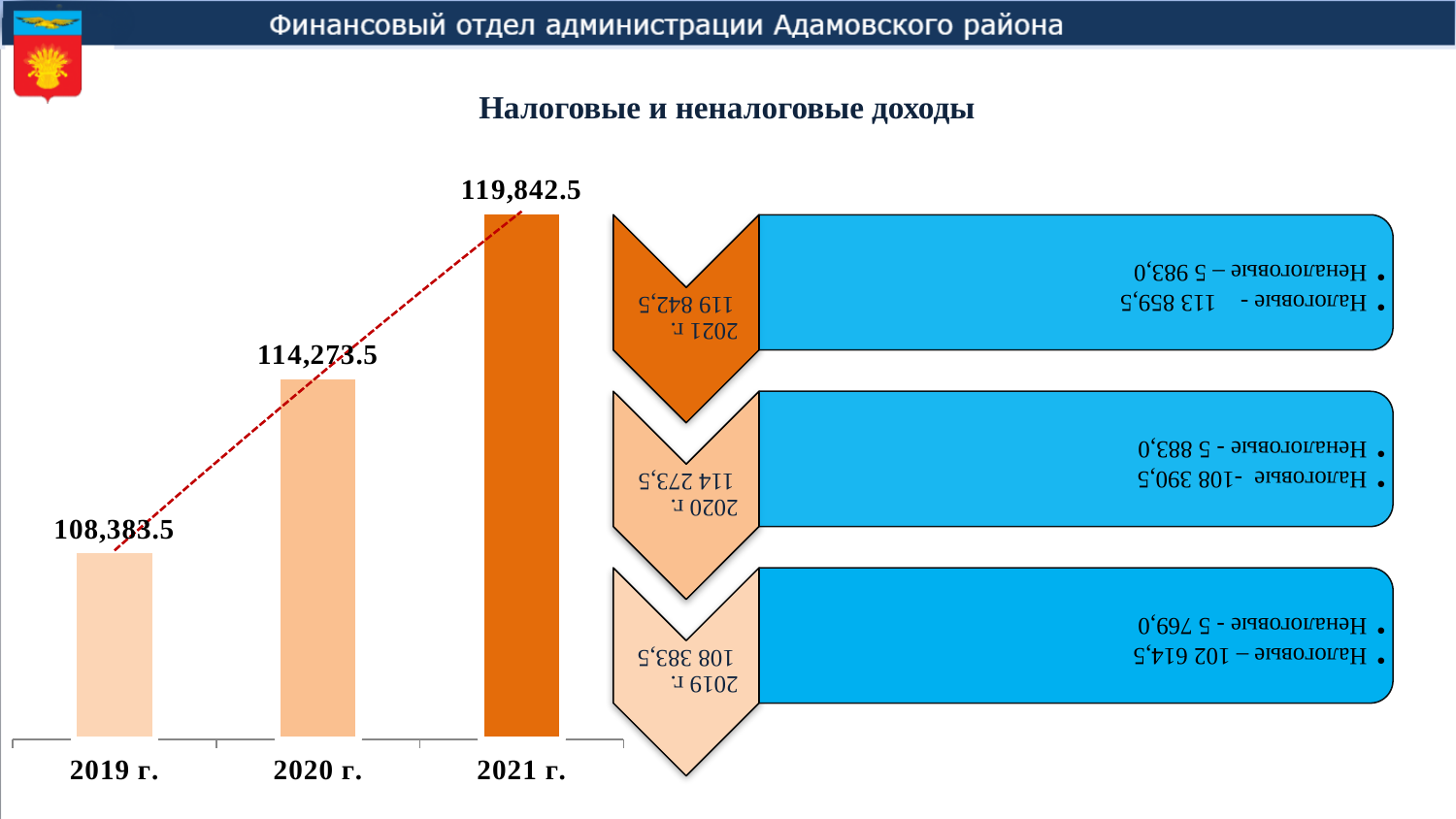
What is the value shown for 2019 г.? 108,383.5 How many years (bars) are shown in the chart? 3 What is the difference between the values for 2021 г. and 2019 г.? 11,459 What is the value shown for 2021 г.? 119,842.5 What is the difference between the values for 2021 г. and 2020 г.? 5,569 Which year has the highest value in the bar chart? 2021 г. What is the difference between the values for 2020 г. and 2019 г.? 5,890 Do the values rise or fall from 2019 г. to 2021 г.? rise Which is larger, the value for 2020 г. or the value for 2019 г.? 2020 г. Which year has the lowest value in the bar chart? 2019 г. What kind of chart is shown on the slide? bar chart What is the value shown for 2020 г.? 114,273.5